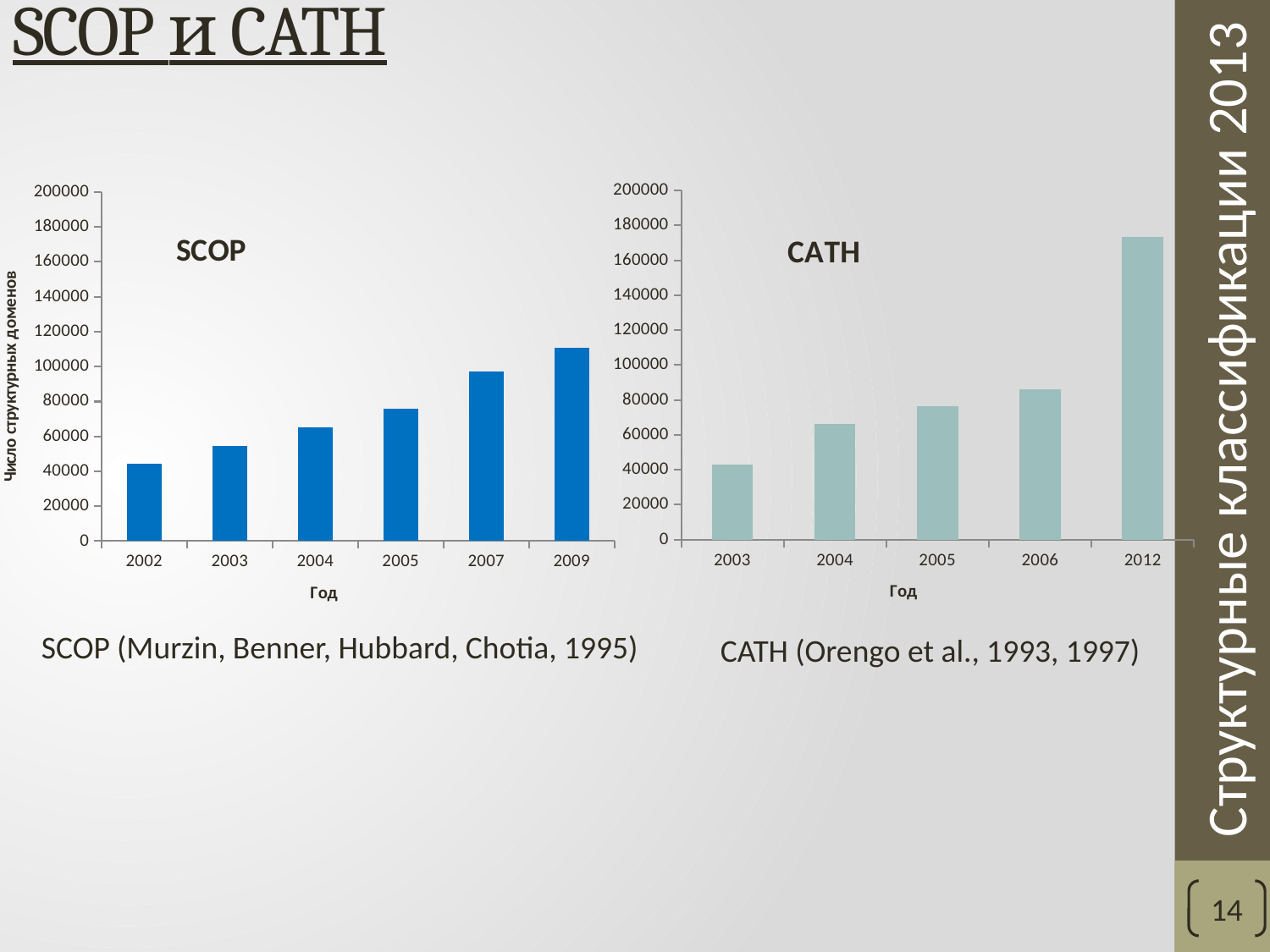
In the CATH chart, which year has the highest value? 2012 In the SCOP chart, is the value for 2009 greater or less than 100000? greater In the SCOP chart, do the values rise or fall from 2002 to 2009? rise In the CATH chart, which is larger, the value for 2004 or the value for 2006? 2006 In the SCOP chart, which year has the lowest number of structural domains? 2002 In the SCOP chart, which year has the highest number of structural domains? 2009 How many years are shown on the x axis of the SCOP chart? 6 How many years are shown on the x axis of the CATH chart? 5 What is the label on the x axis of the SCOP chart? Год In the CATH chart, is the value for 2012 greater or less than 160000? greater In the CATH chart, which year has the lowest value? 2003 What type of chart is the SCOP chart on the left? bar chart